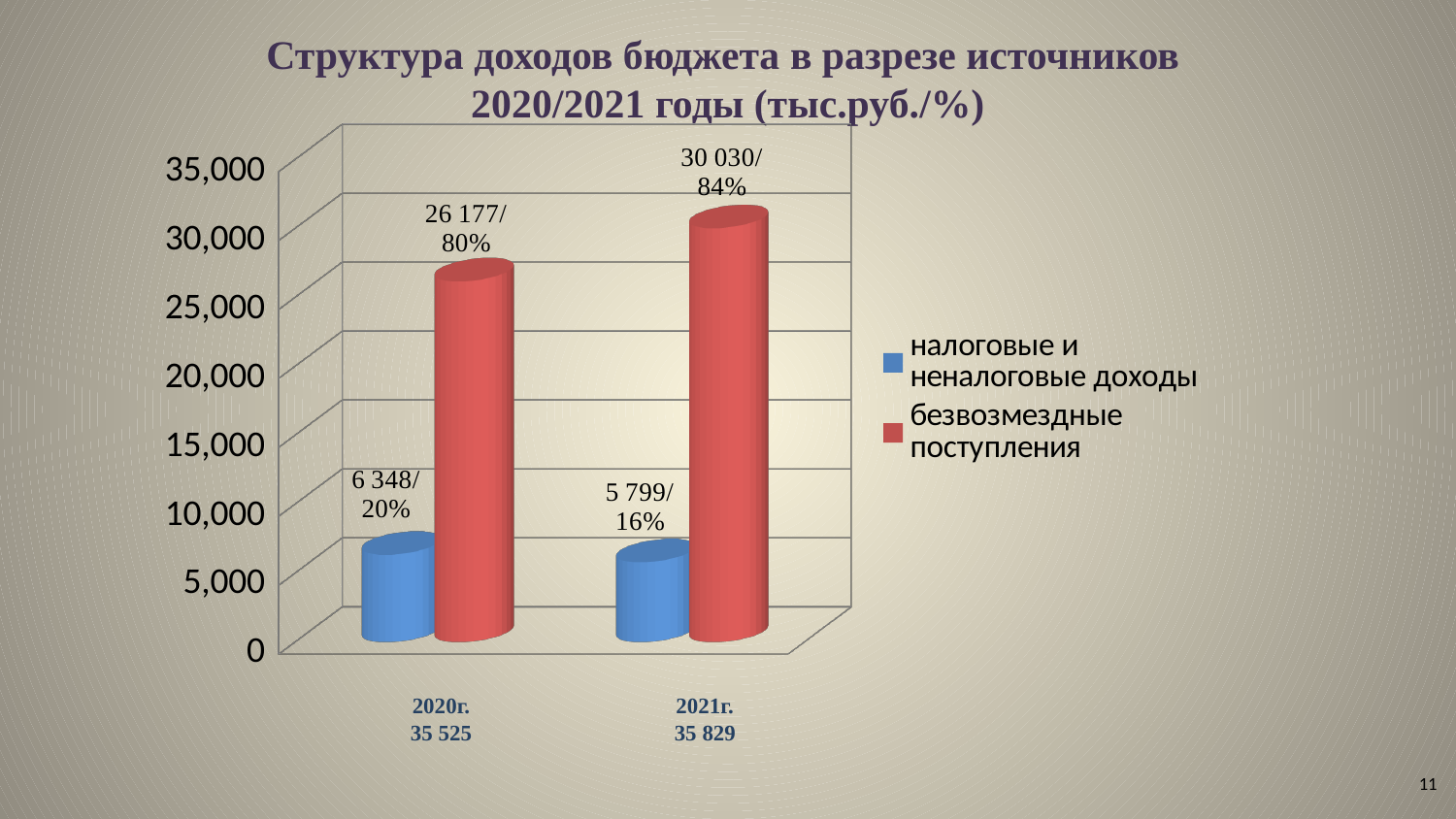
What kind of chart is shown on the slide? Bar chart Which year has the higher value for безвозмездные поступления? 2021г. What is the value for безвозмездные поступления in 2020г.? 26 177/80% What is the value for налоговые и неналоговые доходы in 2021г.? 5 799/16% What is the value for налоговые и неналоговые доходы in 2020г.? 6 348/20% Is the value for налоговые и неналоговые доходы in 2020г. greater or less than 10,000? less Which year has the lower value for налоговые и неналоговые доходы? 2021г. Is the value for безвозмездные поступления in 2021г. greater or less than 30,000? greater What is the value for безвозмездные поступления in 2021г.? 30 030/84% How many categories (years) are shown on the x axis? 2 What colour represents безвозмездные поступления in the chart? Red How many series does the legend list? 2